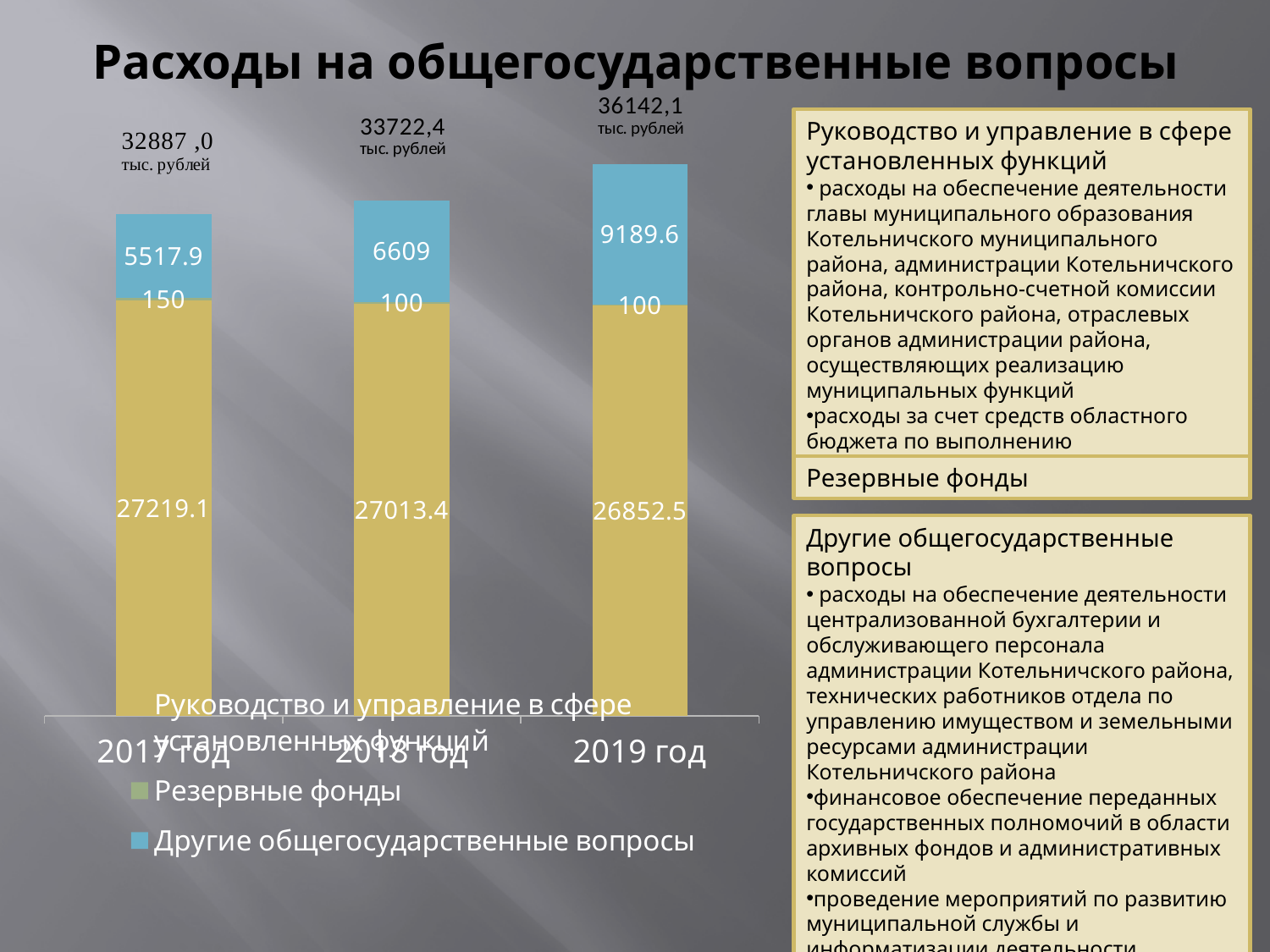
What type of chart is shown on the slide? stacked bar chart How many years (categories) are shown on the x axis of the chart? 3 What is the total shown above the bar for 2018 год? 33722,4 тыс. рублей What is the value of the 'Руководство и управление в сфере установленных функций' segment for 2017 год? 27219.1 What is the title of the slide's chart? Расходы на общегосударственные вопросы Which year has the highest total expenditure? 2019 год What is the value of the 'Резервные фонды' segment for 2018 год? 100 Which year has the lowest value for 'Другие общегосударственные вопросы'? 2017 год What is the difference between the 'Другие общегосударственные вопросы' values for 2019 год and 2018 год? 2580.6 Does the 'Руководство и управление в сфере установленных функций' value rise or fall from 2017 год to 2019 год? fall How many series does the chart legend list? 3 What is the value of the 'Другие общегосударственные вопросы' segment for 2019 год? 9189.6